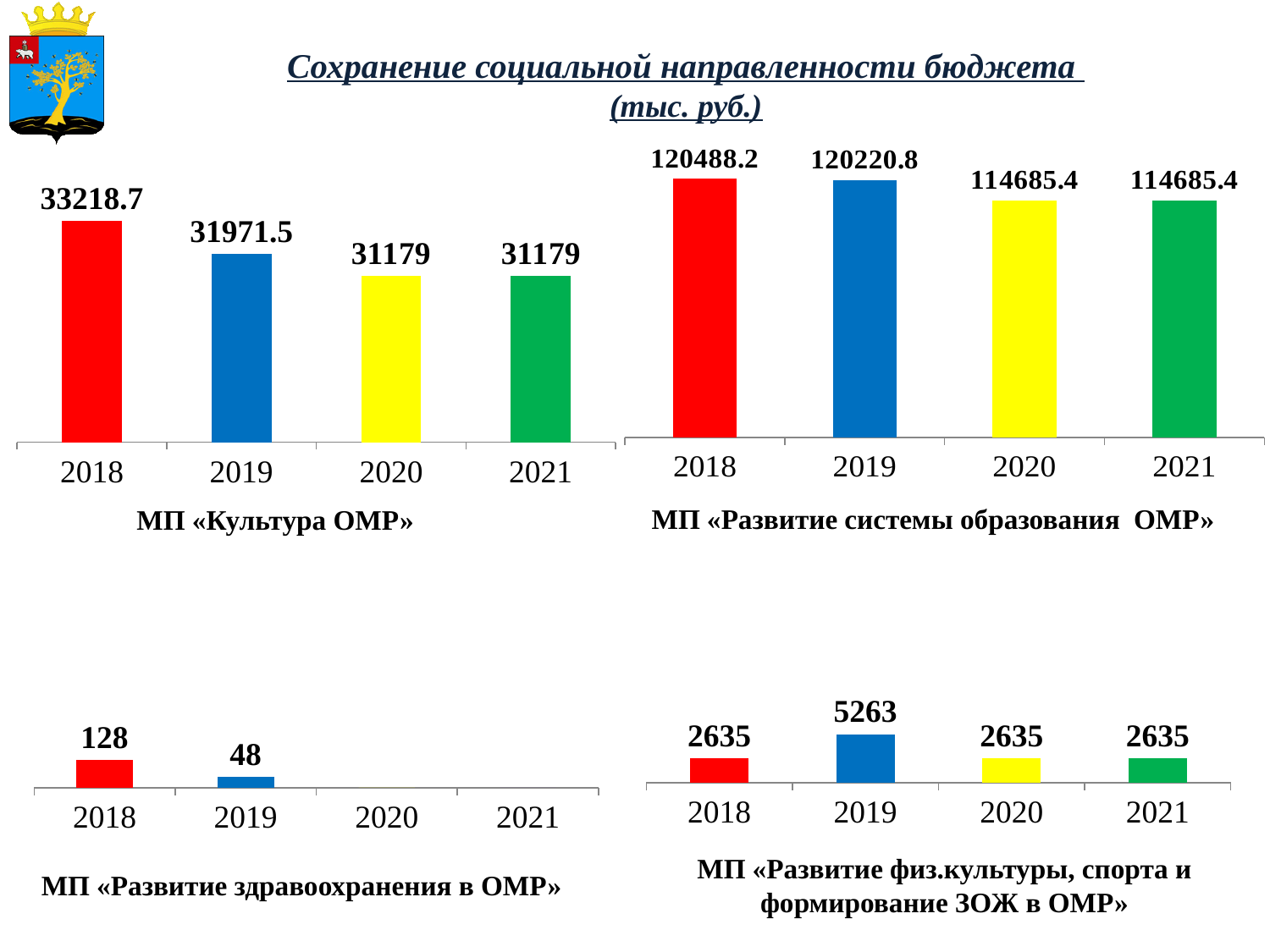
What unit is given in the slide title for the values in the charts? тыс. руб. In the chart titled МП «Культура ОМР», what is the value for 2018? 33218.7 In the chart titled МП «Развитие физ.культуры, спорта и формирование ЗОЖ в ОМР», which year has the highest value? 2019 In the chart titled МП «Культура ОМР», how many years are shown on the x axis? 4 What kind of chart is the one titled МП «Развитие здравоохранения в ОМР»? Bar chart In the chart titled МП «Культура ОМР», what is the difference between the values for 2018 and 2019? 1247.2 In the chart titled МП «Развитие системы образования ОМР», which year has the highest value? 2018 In the chart titled МП «Развитие системы образования ОМР», what is the value for 2020? 114685.4 In the chart titled МП «Развитие системы образования ОМР», what is the difference between the values for 2019 and 2020? 5535.4 In the chart titled МП «Развитие здравоохранения в ОМР», what is the value for 2019? 48 In the chart titled МП «Развитие физ.культуры, спорта и формирование ЗОЖ в ОМР», which is larger, the value for 2018 or 2019? 2019 In the chart titled МП «Культура ОМР», do the values rise or fall from 2018 to 2020? Fall